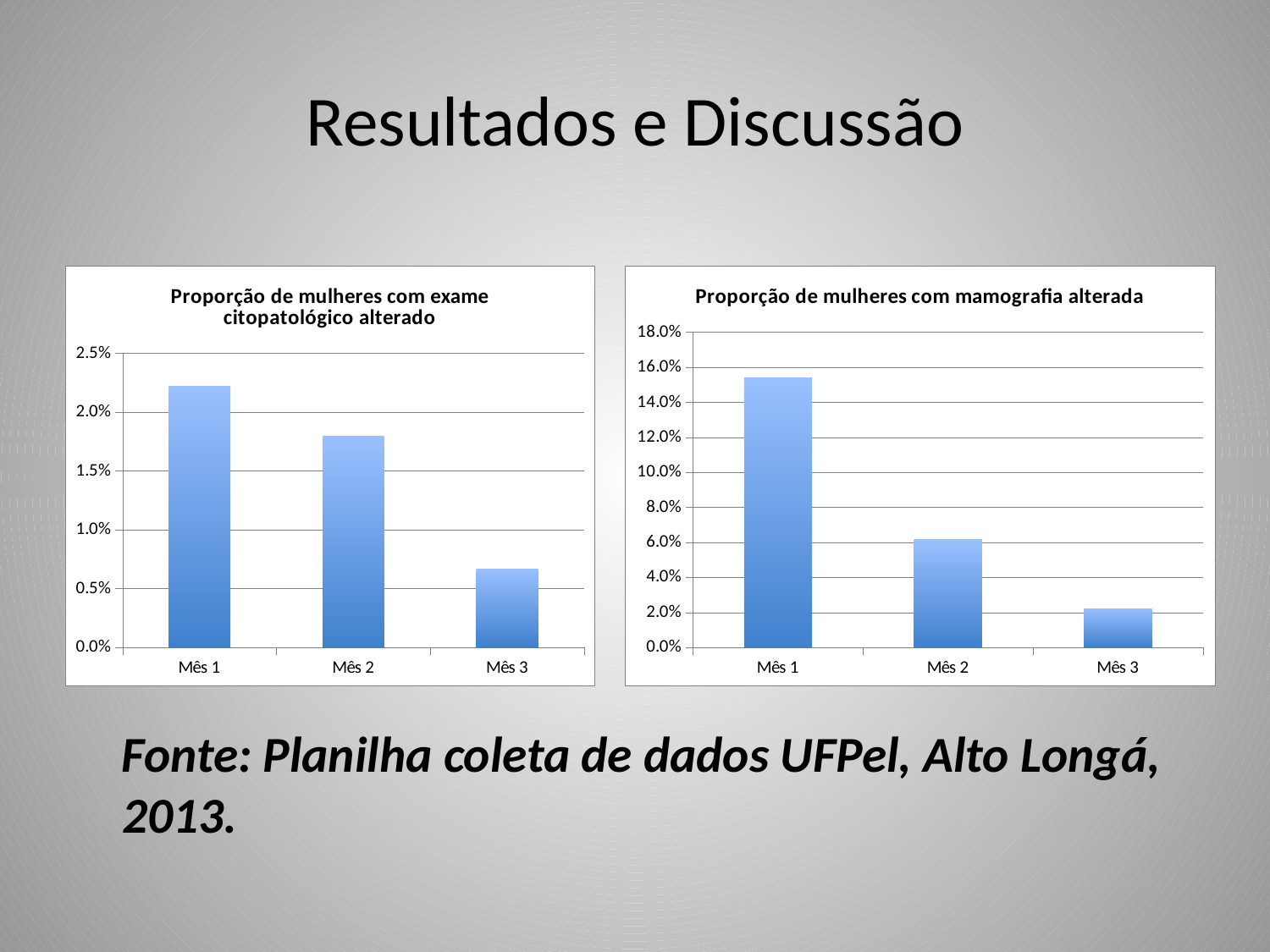
In the chart titled 'Proporção de mulheres com mamografia alterada', which month has the lowest value? Mês 3 In the chart titled 'Proporção de mulheres com exame citopatológico alterado', do the values rise or fall from Mês 1 to Mês 3? fall In the chart titled 'Proporção de mulheres com mamografia alterada', is the value for Mês 1 greater or less than 14.0%? greater In the chart titled 'Proporção de mulheres com exame citopatológico alterado', which month has the lowest value? Mês 3 In the chart titled 'Proporção de mulheres com exame citopatológico alterado', which month has the highest value? Mês 1 In the chart titled 'Proporção de mulheres com mamografia alterada', which month has the highest value? Mês 1 In the chart titled 'Proporção de mulheres com mamografia alterada', which is larger, the value for Mês 2 or Mês 3? Mês 2 What kind of chart is the chart on the left of the slide? bar chart In the chart titled 'Proporção de mulheres com exame citopatológico alterado', is the value for Mês 1 greater or less than 2.0%? greater How many categories are shown on the x axis of the chart titled 'Proporção de mulheres com mamografia alterada'? 3 In the chart titled 'Proporção de mulheres com mamografia alterada', is the value for Mês 2 greater or less than 8.0%? less